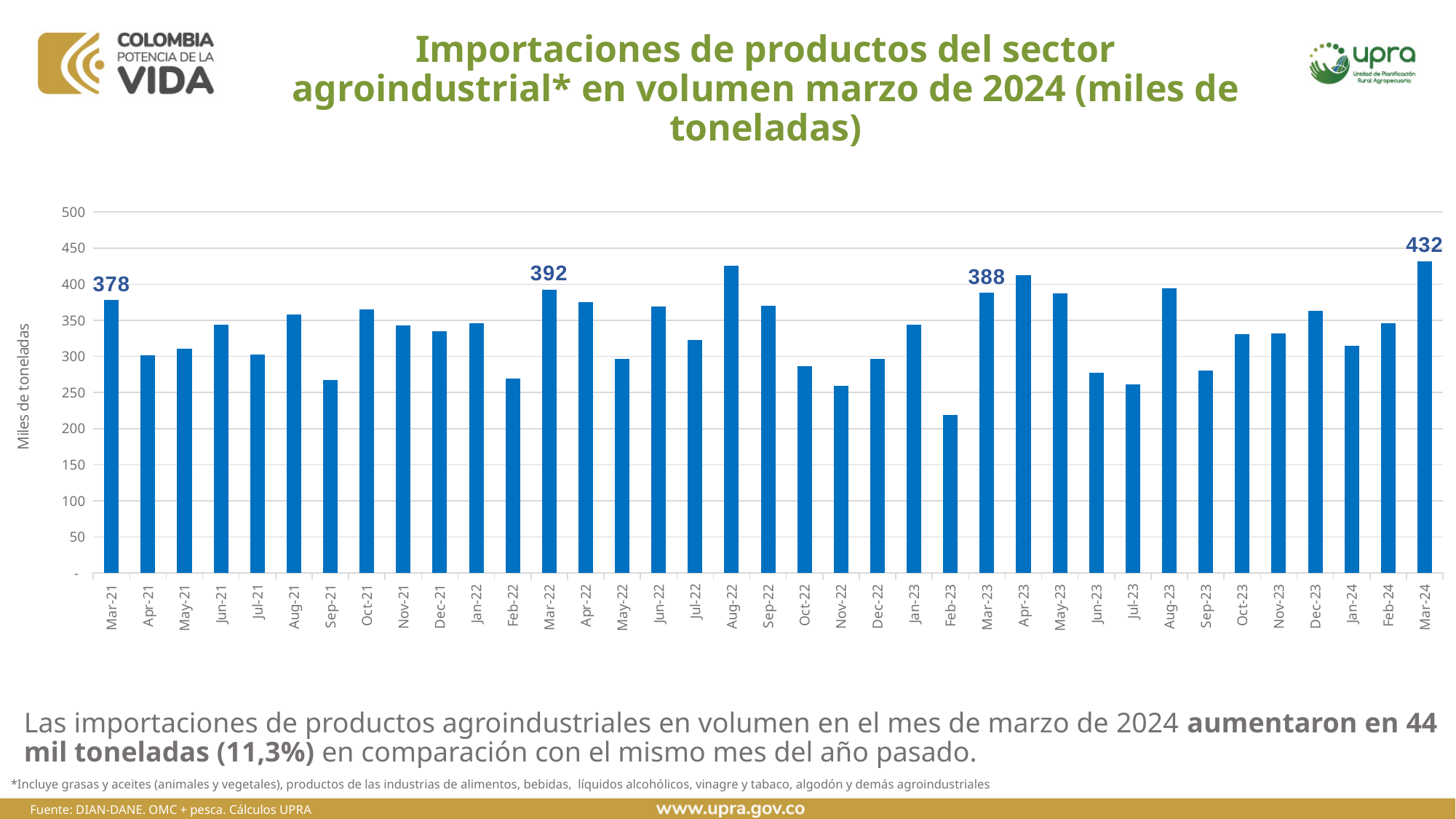
How many months are plotted on the chart? 37 What is the value for Mar-22? 392 Which is larger, the value for Mar-22 or the value for Mar-23? Mar-22 Which month has the highest value? Mar-24 What kind of chart is shown? bar chart What is the difference between the values for Mar-24 and Mar-23? 44 Is the value for Feb-23 greater or less than 250? less What is the value for Mar-24? 432 What is the value for Mar-23? 388 What is the value for Mar-21? 378 Is the value for Aug-22 greater or less than 400? greater Which month has the lowest value? Feb-23